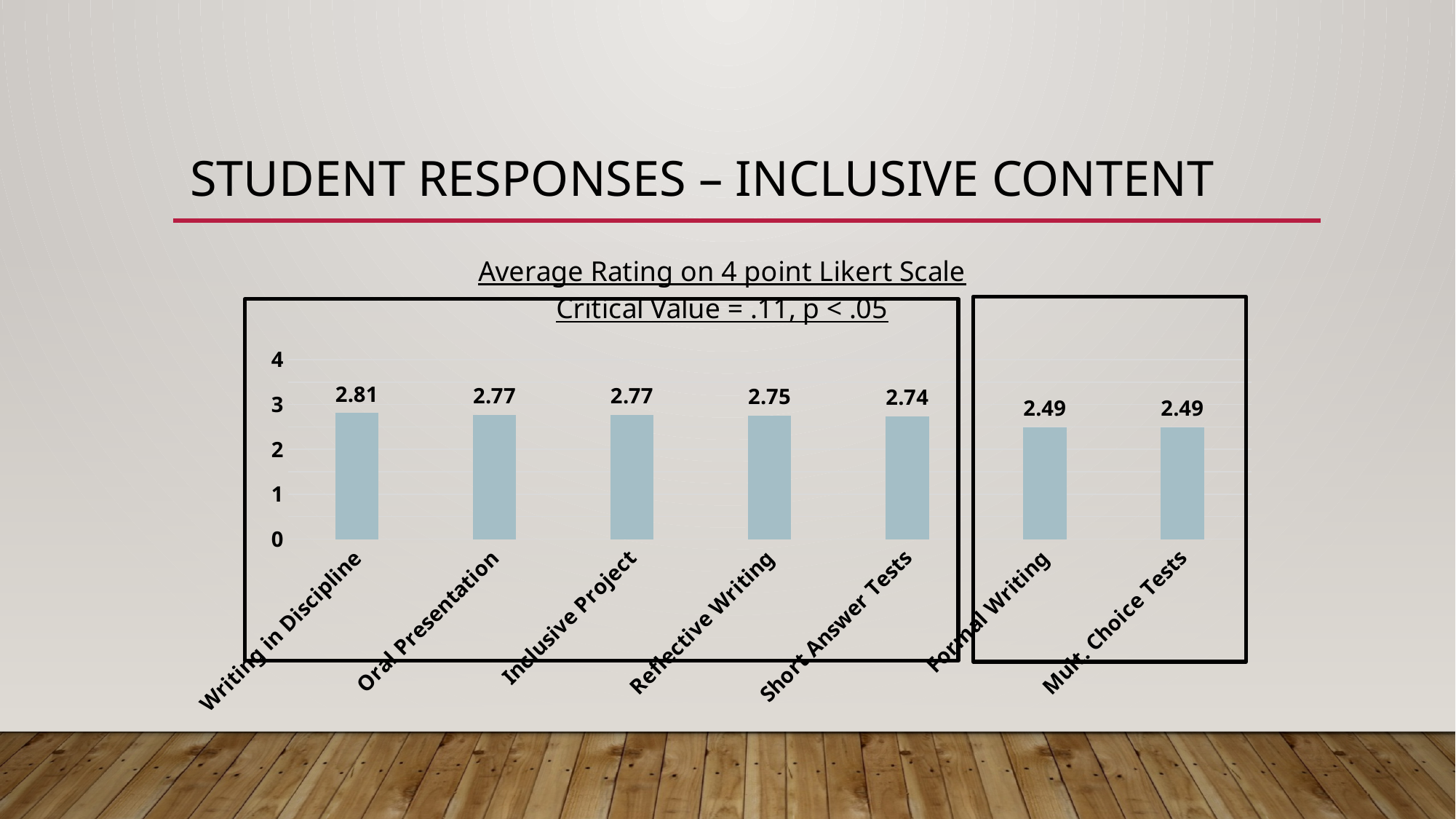
What is the average rating for Short Answer Tests? 2.74 Which category has the highest average rating? Writing in Discipline Do the average ratings rise or fall from left to right across the categories? fall What is the average rating for Writing in Discipline? 2.81 What kind of chart is shown on the slide? bar chart What is the difference between the average ratings for Writing in Discipline and Mult. Choice Tests? 0.32 Which has a higher average rating, Inclusive Project or Formal Writing? Inclusive Project Is the value for Mult. Choice Tests greater or less than 3? less What is the difference between the average ratings for Oral Presentation and Short Answer Tests? 0.03 How many categories are shown in the chart? 7 What is the average rating for Reflective Writing? 2.75 What is the average rating for Formal Writing? 2.49